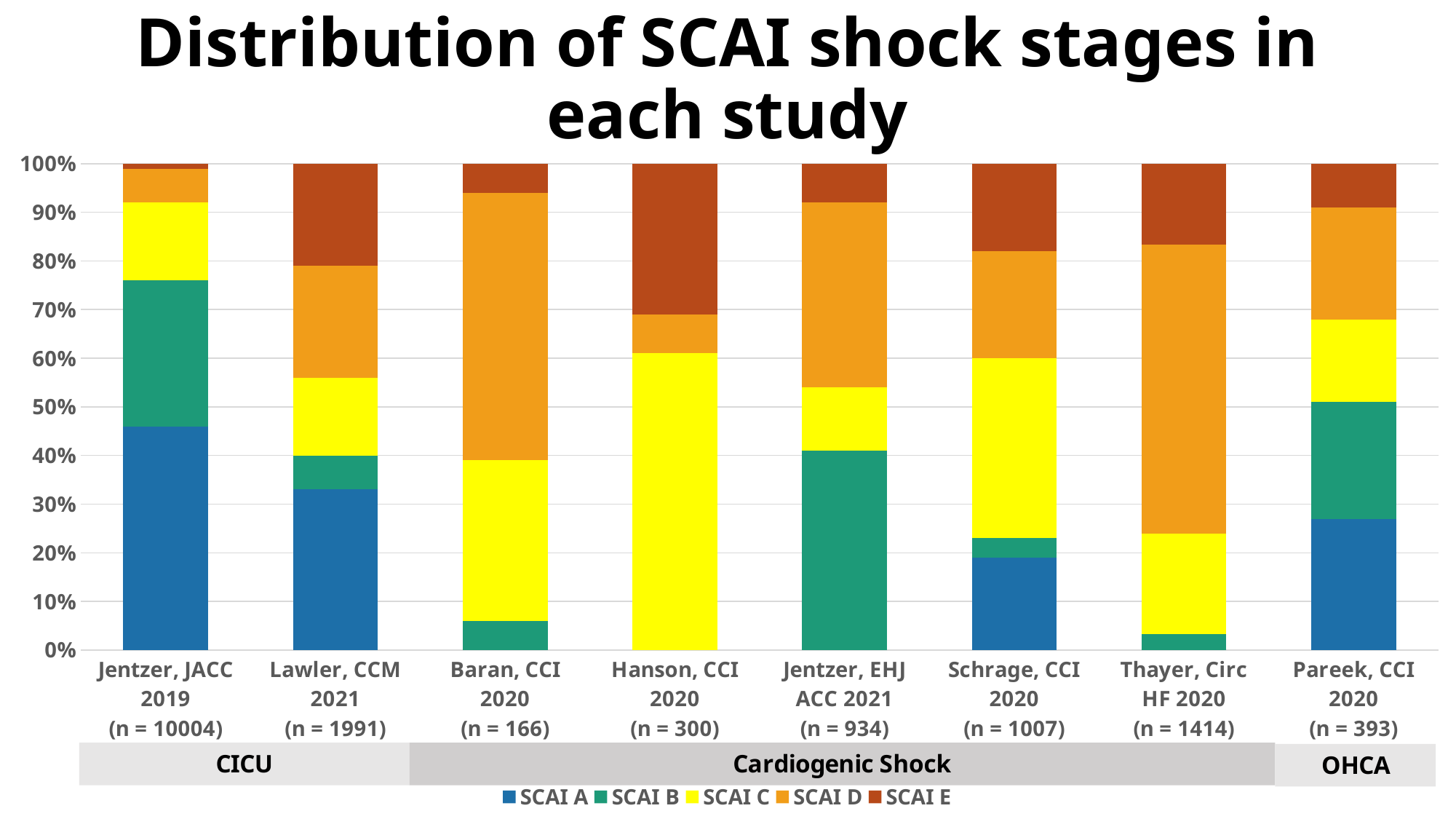
How many studies are plotted along the x axis? 8 Which study has the largest SCAI E share? Hanson, CCI 2020 Is the SCAI A share for Jentzer, JACC 2019 greater or less than 40%? greater How many series does the legend list? 5 Is the SCAI C share for Hanson, CCI 2020 greater or less than 50%? greater Which study has the largest SCAI C share? Hanson, CCI 2020 What kind of chart is shown on the slide? Stacked bar chart What is the title of the chart? Distribution of SCAI shock stages in each study Which study has the largest SCAI A share? Jentzer, JACC 2019 Which study has a larger SCAI A share, Lawler, CCM 2021 or Pareek, CCI 2020? Lawler, CCM 2021 How many studies are grouped under the Cardiogenic Shock label? 5